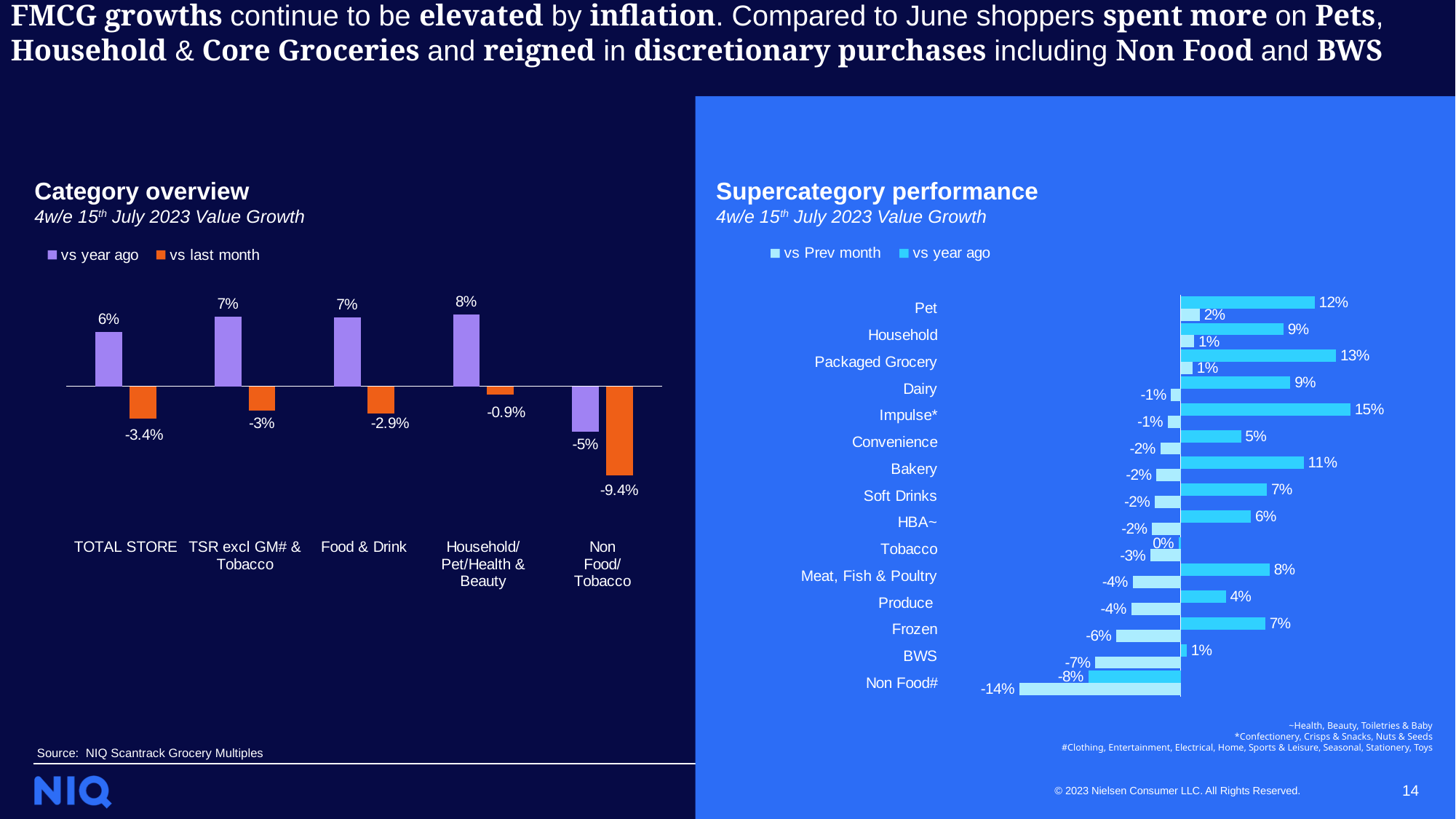
How many categories are shown in the 'Category overview' chart? 5 In the 'Supercategory performance' chart, which is larger: the highest value for Packaged Grocery or the highest value for Bakery? Packaged Grocery In the 'Category overview' chart, what is the difference between the 'vs year ago' and 'vs last month' values for TOTAL STORE? 9.4 percentage points In the 'Supercategory performance' chart, which category has the highest value shown? Impulse* How many series does the legend of the 'Category overview' chart list? 2 How many categories are listed in the 'Supercategory performance' chart? 15 In the 'Supercategory performance' chart, which category has the lowest value shown? Non Food# In the 'Category overview' chart, what is the 'vs last month' value for Non Food/Tobacco? -9.4% In the 'Category overview' chart, what is the 'vs last month' value for Household/Pet/Health & Beauty? -0.9% In the 'Category overview' chart, which category has the highest 'vs year ago' value? Household/Pet/Health & Beauty What kind of chart is the 'Category overview' chart on the left? Bar chart In the 'Category overview' chart, what is the 'vs year ago' value for TOTAL STORE? 6%